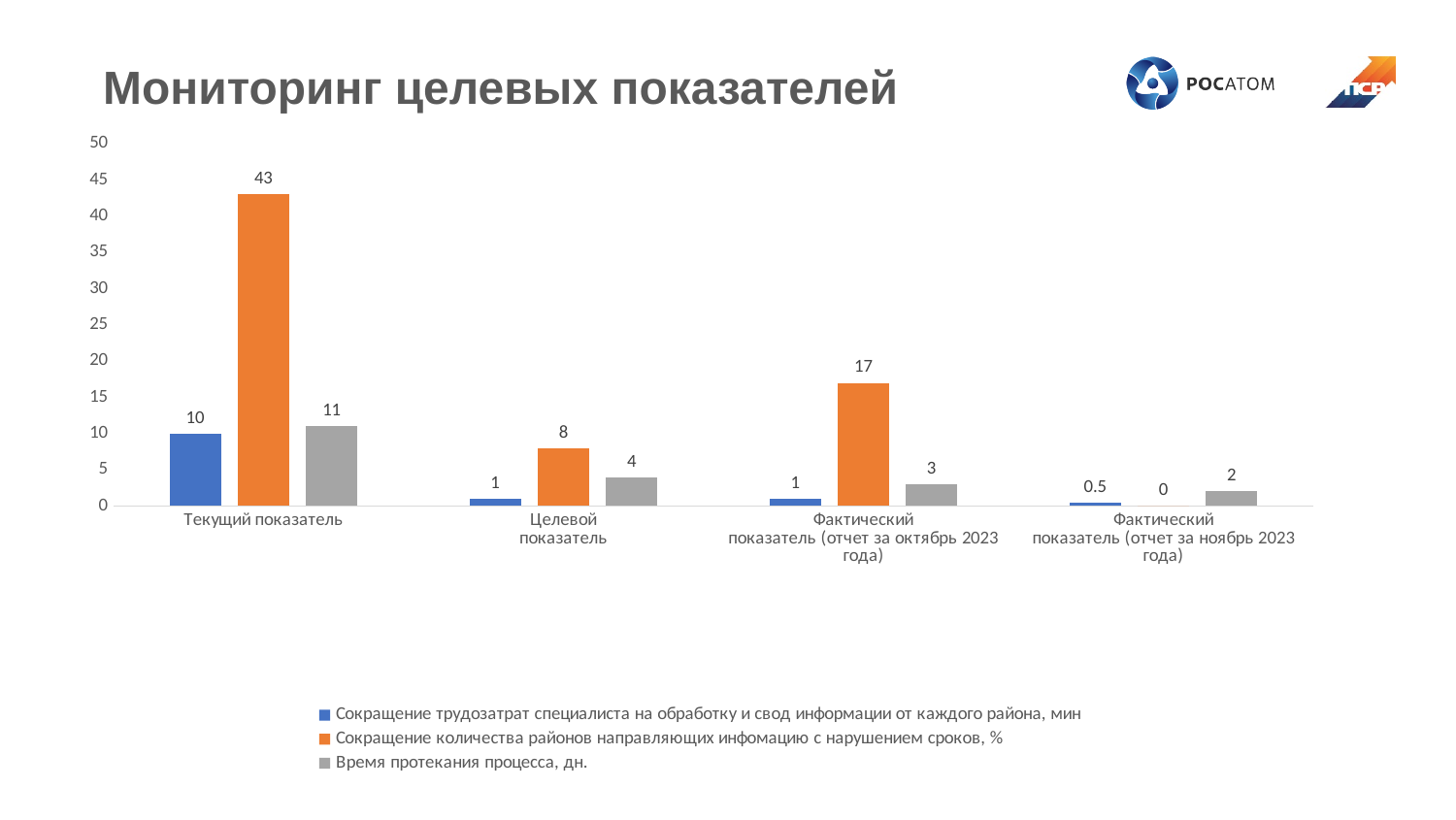
What is the value of 'Время протекания процесса, дн.' for 'Целевой показатель'? 4 How many series does the legend list? 3 Which is larger: 'Время протекания процесса, дн.' for 'Текущий показатель' or for 'Фактический показатель (отчет за октябрь 2023 года)'? Текущий показатель Is the value of 'Сокращение количества районов направляющих инфомацию с нарушением сроков, %' for 'Текущий показатель' greater or less than 40? greater How many categories are shown on the x axis of the chart? 4 What is the value of 'Сокращение количества районов направляющих инфомацию с нарушением сроков, %' for 'Фактический показатель (отчет за октябрь 2023 года)'? 17 Which category has the highest value for 'Сокращение количества районов направляющих инфомацию с нарушением сроков, %'? Текущий показатель What is the difference between the 'Сокращение количества районов направляющих инфомацию с нарушением сроков, %' values for 'Текущий показатель' and 'Целевой показатель'? 35 Which category has the lowest value for 'Время протекания процесса, дн.'? Фактический показатель (отчет за ноябрь 2023 года) What is the value of 'Сокращение количества районов направляющих инфомацию с нарушением сроков, %' for 'Текущий показатель'? 43 What is the value of 'Сокращение трудозатрат специалиста на обработку и свод информации от каждого района, мин' for 'Фактический показатель (отчет за ноябрь 2023 года)'? 0.5 What type of chart is shown on the slide? Bar chart